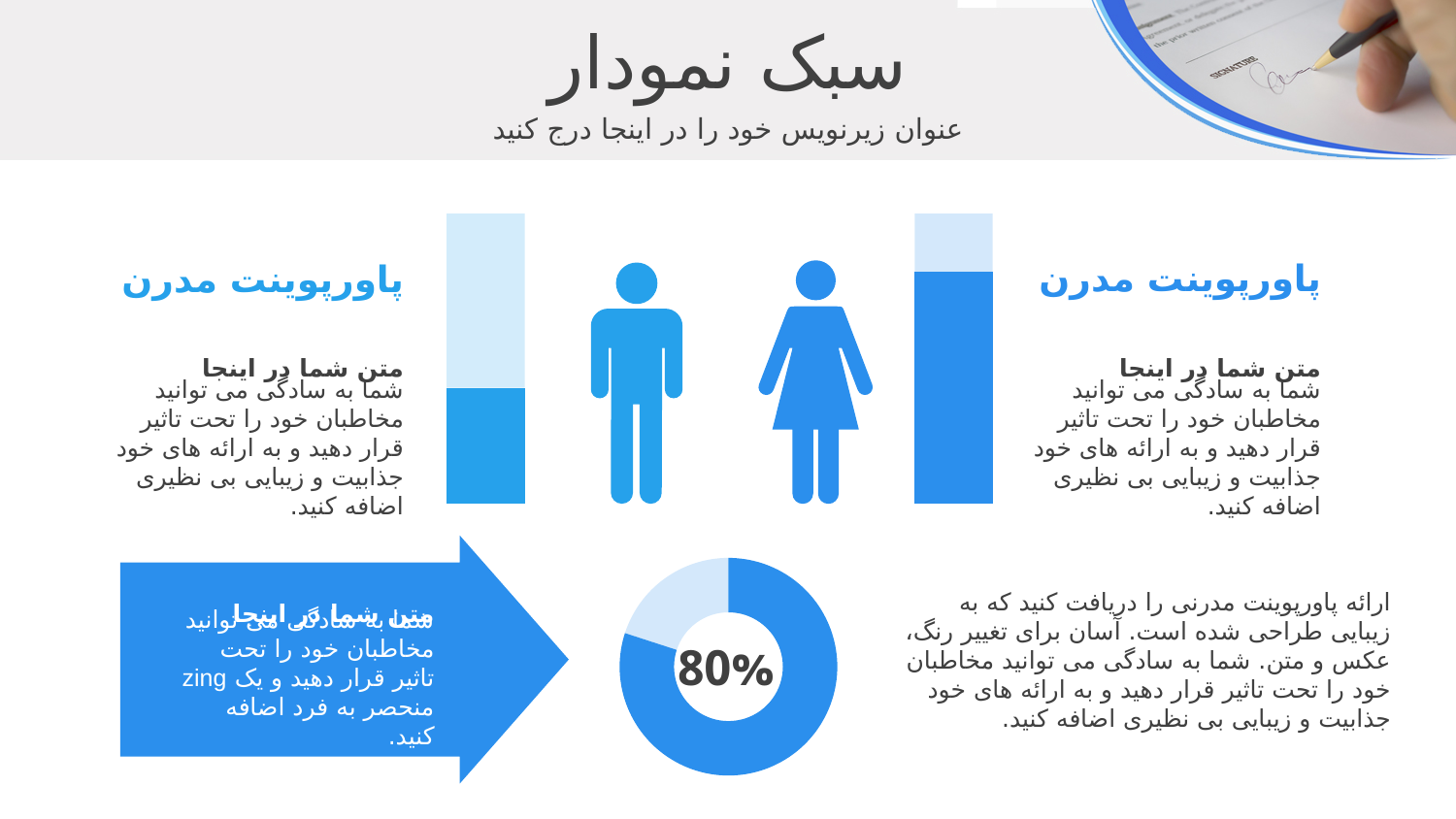
Of the two vertical bars beside the person icons, which one has the larger dark blue filled portion, the left bar or the right bar? the right bar What share of the donut chart does the dark blue segment represent? 80% What value is printed in the centre of the donut chart? 80% Is the dark blue segment of the donut chart greater or less than 50%? greater What colour is the larger segment of the donut chart? dark blue What kind of chart is shown at the bottom centre of the slide? donut chart Which segment of the donut chart is larger, the dark blue one or the light blue one? the dark blue one How many segments does the donut chart have? 2